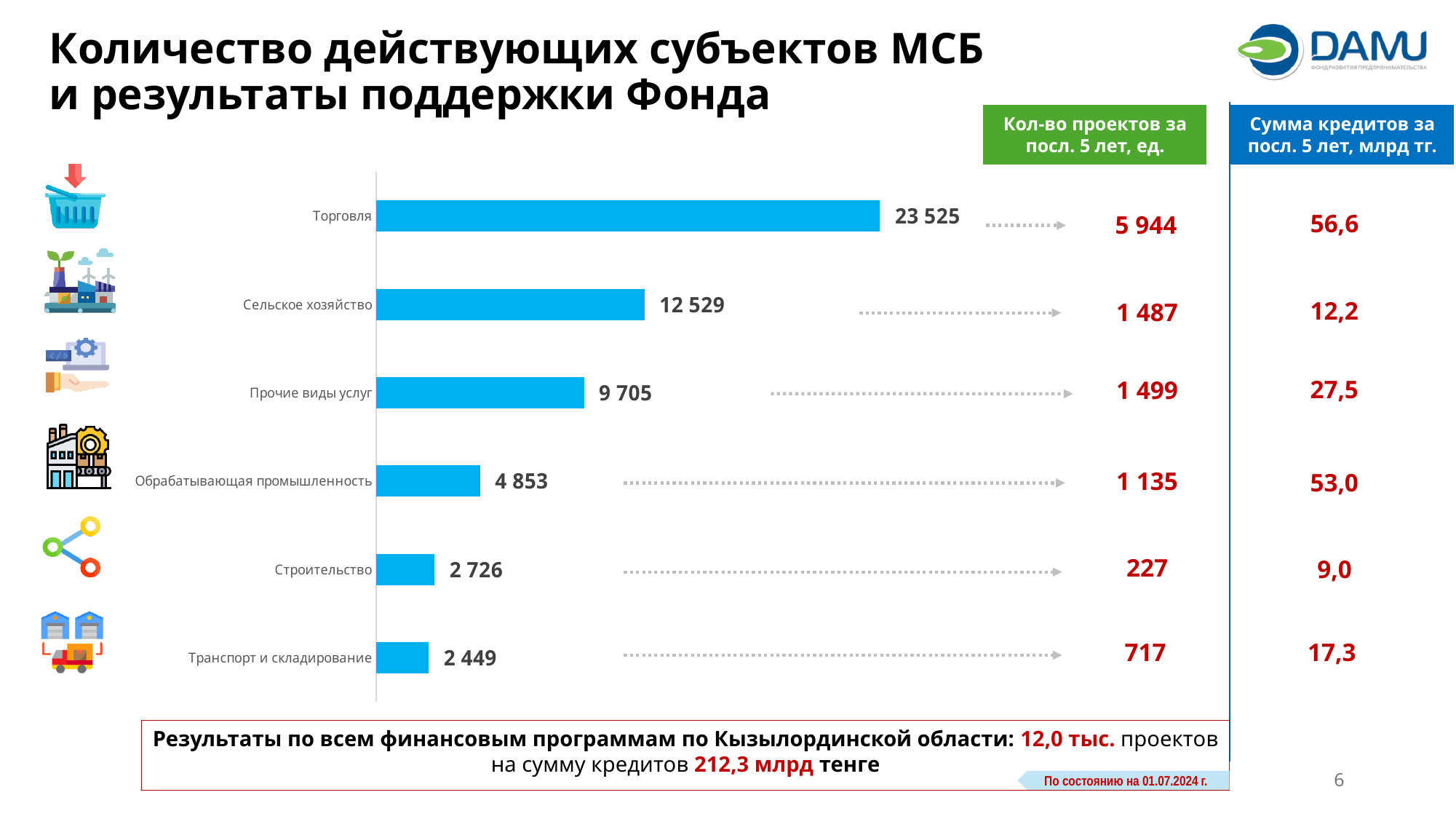
What is the value for Обрабатывающая промышленность in the bar chart? 4 853 What is the difference between the values for Строительство and Транспорт и складирование? 277 Which category has the lowest value in the bar chart? Транспорт и складирование What is the difference between the values for Торговля and Сельское хозяйство? 10 996 What colour are the bars in the chart? Light blue What is the value for Торговля in the bar chart? 23 525 Which category has the highest value in the bar chart? Торговля What kind of chart is shown on the slide? Bar chart What is the value for Транспорт и складирование in the bar chart? 2 449 How many categories does the bar chart show? 6 What is the value for Сельское хозяйство in the bar chart? 12 529 Which is larger in the bar chart: Прочие виды услуг or Строительство? Прочие виды услуг